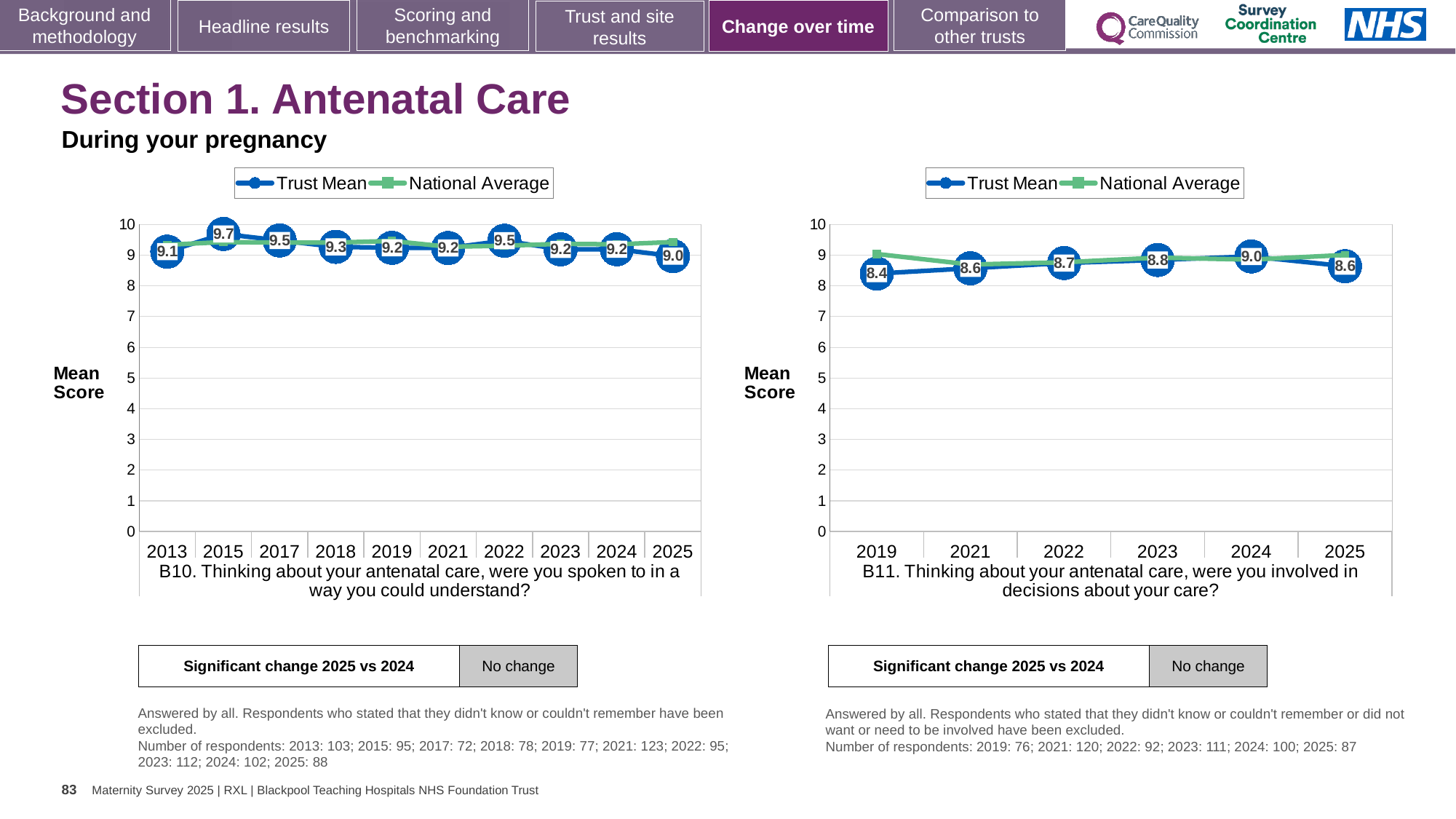
In the B11 chart on the right, what is the Trust Mean for 2019? 8.4 In the B10 chart on the left, which year has the lowest Trust Mean? 2025 In the B10 chart on the left, what is the Trust Mean for 2015? 9.7 In the B10 chart on the left, which year has the highest Trust Mean? 2015 In the B11 chart on the right, which year has the highest Trust Mean? 2024 In the B11 chart on the right, how many series does the legend list? 2 In the B10 chart on the left, what is the difference between the Trust Mean in 2015 and in 2025? 0.7 What kind of chart is the B11 chart on the right? line chart In the B10 chart on the left, how many years are shown on the x axis? 10 In the B11 chart on the right, which year has the lowest Trust Mean? 2019 In the B11 chart on the right, is the Trust Mean for 2024 larger or smaller than the Trust Mean for 2025? larger In the B10 chart on the left, what is the Trust Mean for 2025? 9.0